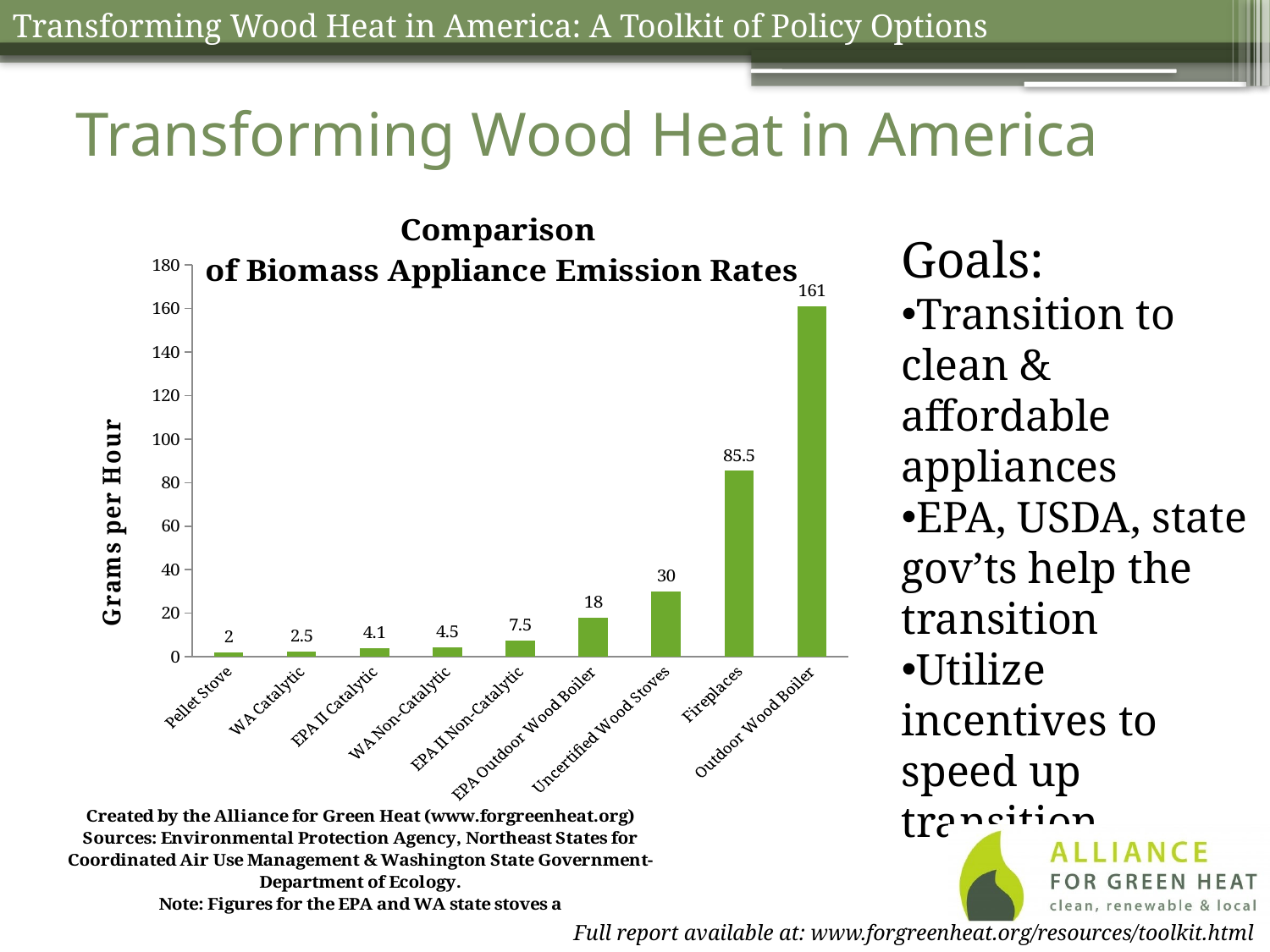
What is the difference in emission rate between Uncertified Wood Stoves and EPA Outdoor Wood Boiler? 12 What is the emission rate for Fireplaces? 85.5 How many appliance categories are shown in the chart? 9 Which has a higher emission rate, WA Non-Catalytic or EPA II Catalytic? WA Non-Catalytic Which appliance has the lowest emission rate? Pellet Stove What is the emission rate for Outdoor Wood Boiler? 161 What is the label of the y axis? Grams per Hour What kind of chart is shown on the slide? Bar chart Is the value for Fireplaces greater or less than 100? less Which appliance has the highest emission rate? Outdoor Wood Boiler What is the emission rate for EPA II Non-Catalytic? 7.5 What is the difference in emission rate between Outdoor Wood Boiler and Fireplaces? 75.5